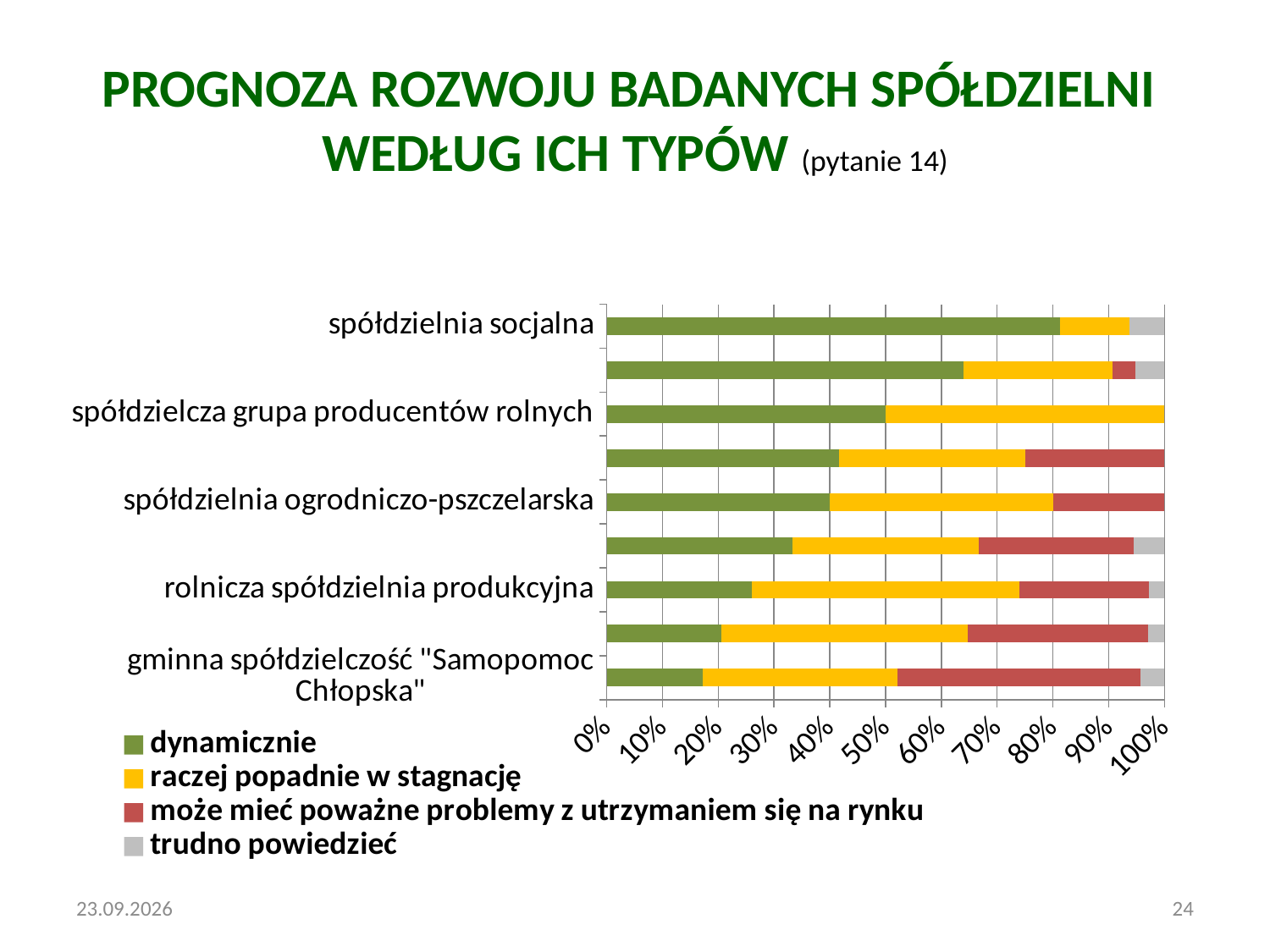
What kind of chart is shown on the slide? stacked bar chart Which category has the largest 'dynamicznie' share? spółdzielnia socjalna How many bars are plotted in the chart? 9 Is the 'dynamicznie' value for rolnicza spółdzielnia produkcyjna greater or less than 30%? less Which colour represents 'trudno powiedzieć' in the chart? grey Which has a larger 'dynamicznie' share: spółdzielnia socjalna or spółdzielnia ogrodniczo-pszczelarska? spółdzielnia socjalna Which labelled category has the smallest 'dynamicznie' share? gminna spółdzielczość "Samopomoc Chłopska" Is the 'dynamicznie' value for gminna spółdzielczość "Samopomoc Chłopska" greater or less than 20%? less Is the 'dynamicznie' value for spółdzielcza grupa producentów rolnych greater or less than 40%? greater How many series does the legend list? 4 Which legend entry is shown in red? może mieć poważne problemy z utrzymaniem się na rynku